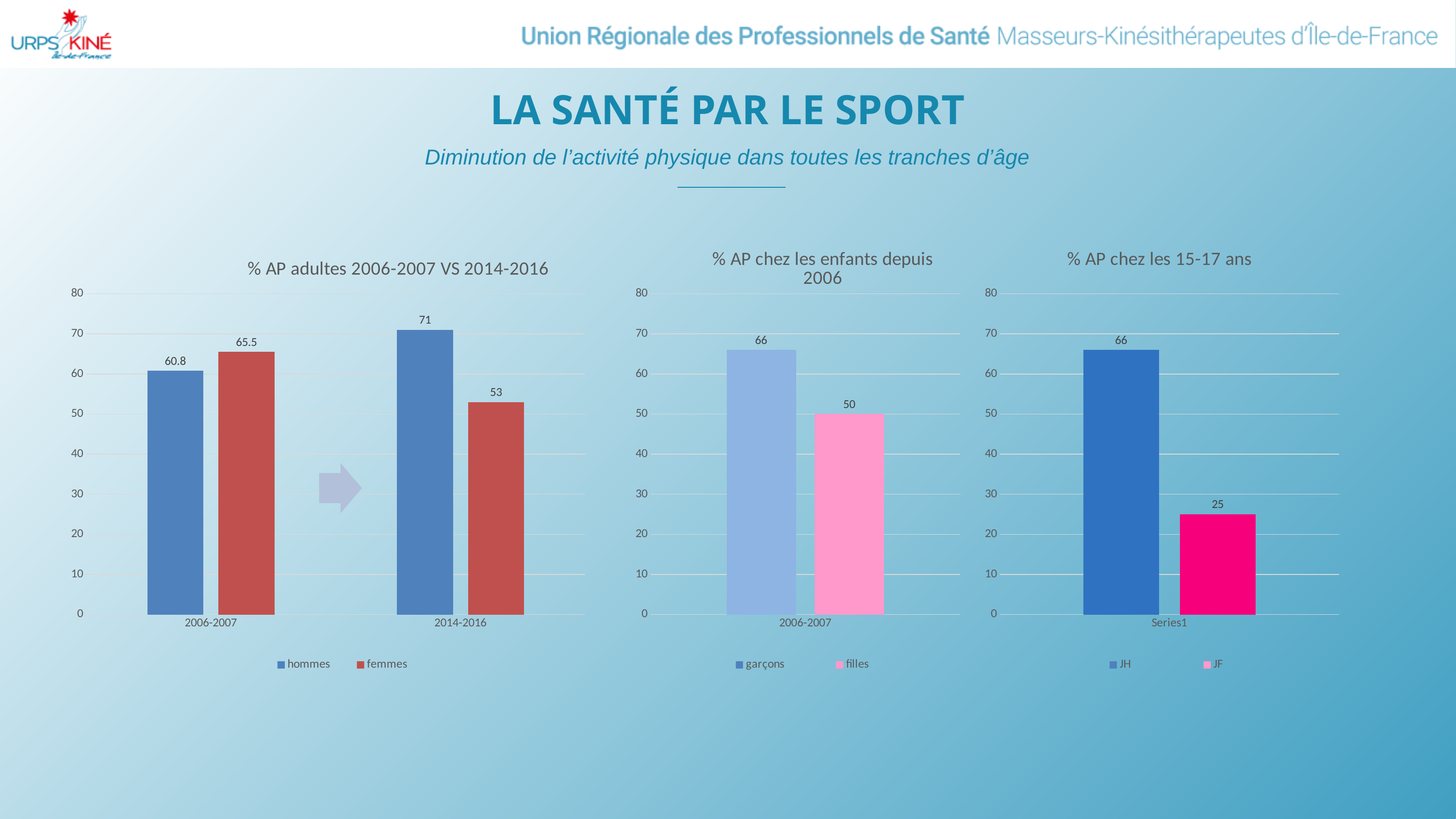
In the chart '% AP adultes 2006-2007 VS 2014-2016', what is the value for femmes in 2014-2016? 53 In the chart '% AP chez les 15-17 ans', what is the value for JF? 25 In the chart '% AP adultes 2006-2007 VS 2014-2016', what is the value for hommes in 2006-2007? 60.8 In the chart '% AP chez les enfants depuis 2006', what is the value for filles? 50 In the chart '% AP adultes 2006-2007 VS 2014-2016', does the value for femmes rise or fall from 2006-2007 to 2014-2016? fall In the chart '% AP chez les 15-17 ans', which series has the highest value? JH In the chart '% AP adultes 2006-2007 VS 2014-2016', how many series does the legend list? 2 In the chart '% AP adultes 2006-2007 VS 2014-2016', which is larger in 2006-2007, hommes or femmes? femmes In the chart '% AP adultes 2006-2007 VS 2014-2016', what is the difference between hommes and femmes in 2014-2016? 18 What kind of chart is '% AP chez les enfants depuis 2006'? bar chart In the chart '% AP chez les enfants depuis 2006', what is the difference between garçons and filles? 16 In the chart '% AP chez les 15-17 ans', what is the difference between JH and JF? 41